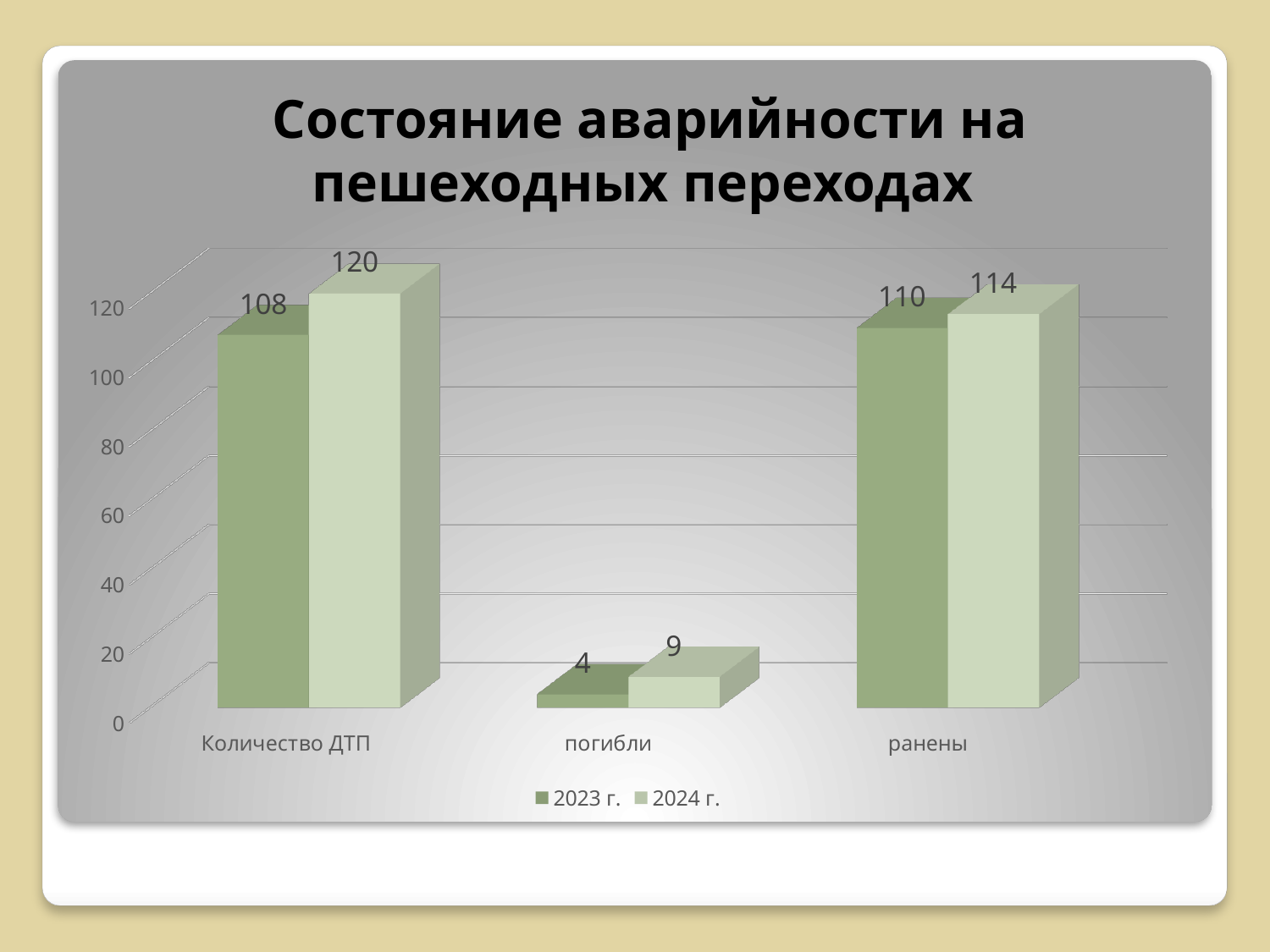
Which category has the highest value in 2024 г.? Количество ДТП What is the value for ранены in 2024 г.? 114 What is the value for Количество ДТП in 2024 г.? 120 How many series does the legend list? 2 What is the value for Количество ДТП in 2023 г.? 108 How many categories are shown on the x axis? 3 Which category has the lowest value in 2023 г.? погибли What is the value for погибли in 2023 г.? 4 What is the difference between the 2024 г. and 2023 г. values for Количество ДТП? 12 What kind of chart is shown on the slide? bar chart What is the value for погибли in 2024 г.? 9 Which is larger: the 2023 г. value for ранены or the 2023 г. value for Количество ДТП? ранены